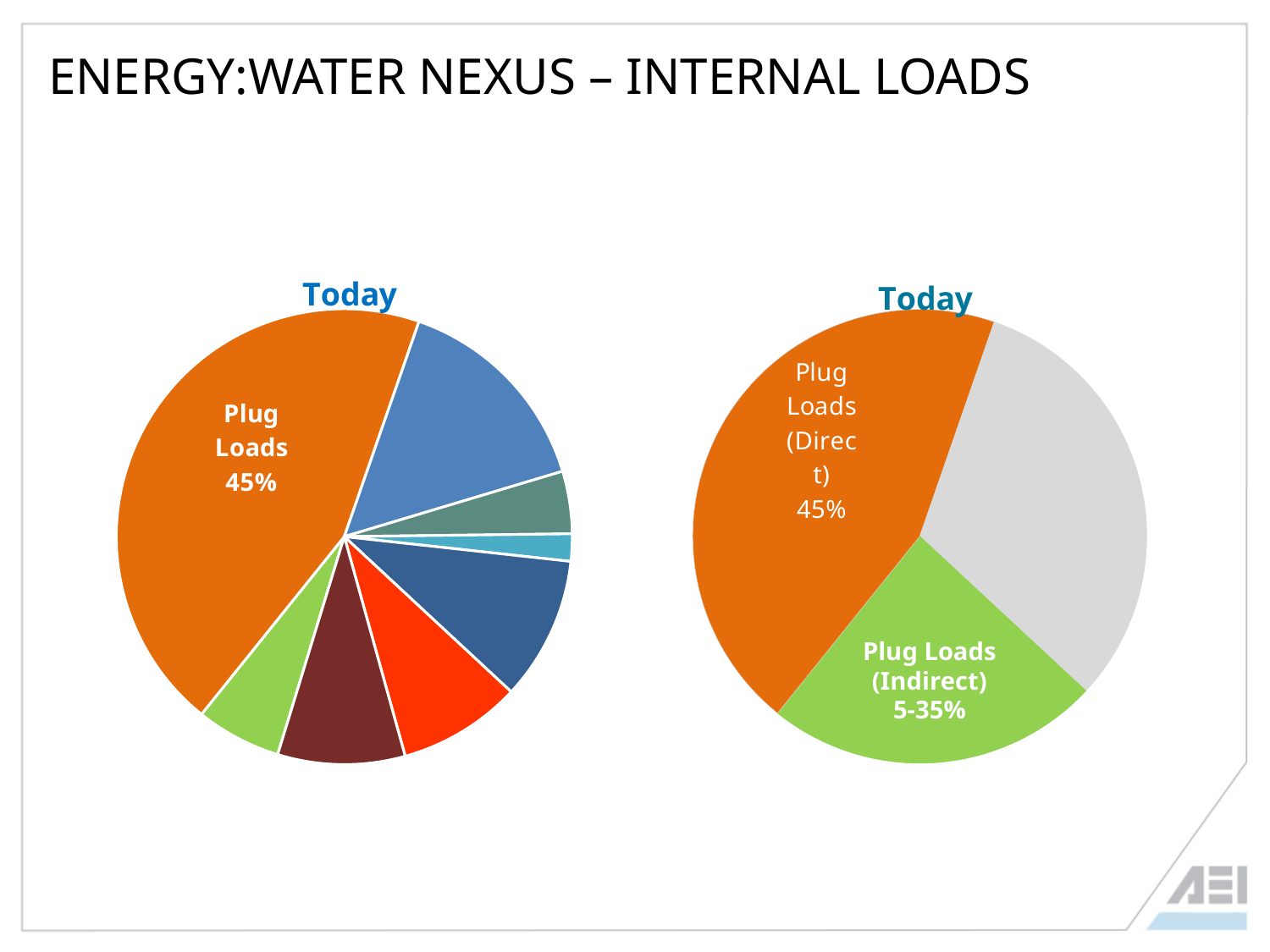
What kind of chart is the chart on the right of the slide? Pie chart In the left pie chart, which slice is the largest? Plug Loads In the right pie chart, what value is shown for Plug Loads (Indirect)? 5-35% In the right pie chart, what value is shown for Plug Loads (Direct)? 45% What kind of chart is the chart on the left of the slide? Pie chart In the right pie chart, is the Plug Loads (Direct) slice larger or smaller than the Plug Loads (Indirect) slice? Larger In the left pie chart, what share is labelled for Plug Loads? 45% How many slices does the left pie chart have? 8 In the right pie chart, what colour is the Plug Loads (Indirect) slice? Green In the right pie chart, which labelled slice is the largest? Plug Loads (Direct) How many slices does the right pie chart have? 3 What is the title of the left pie chart? Today